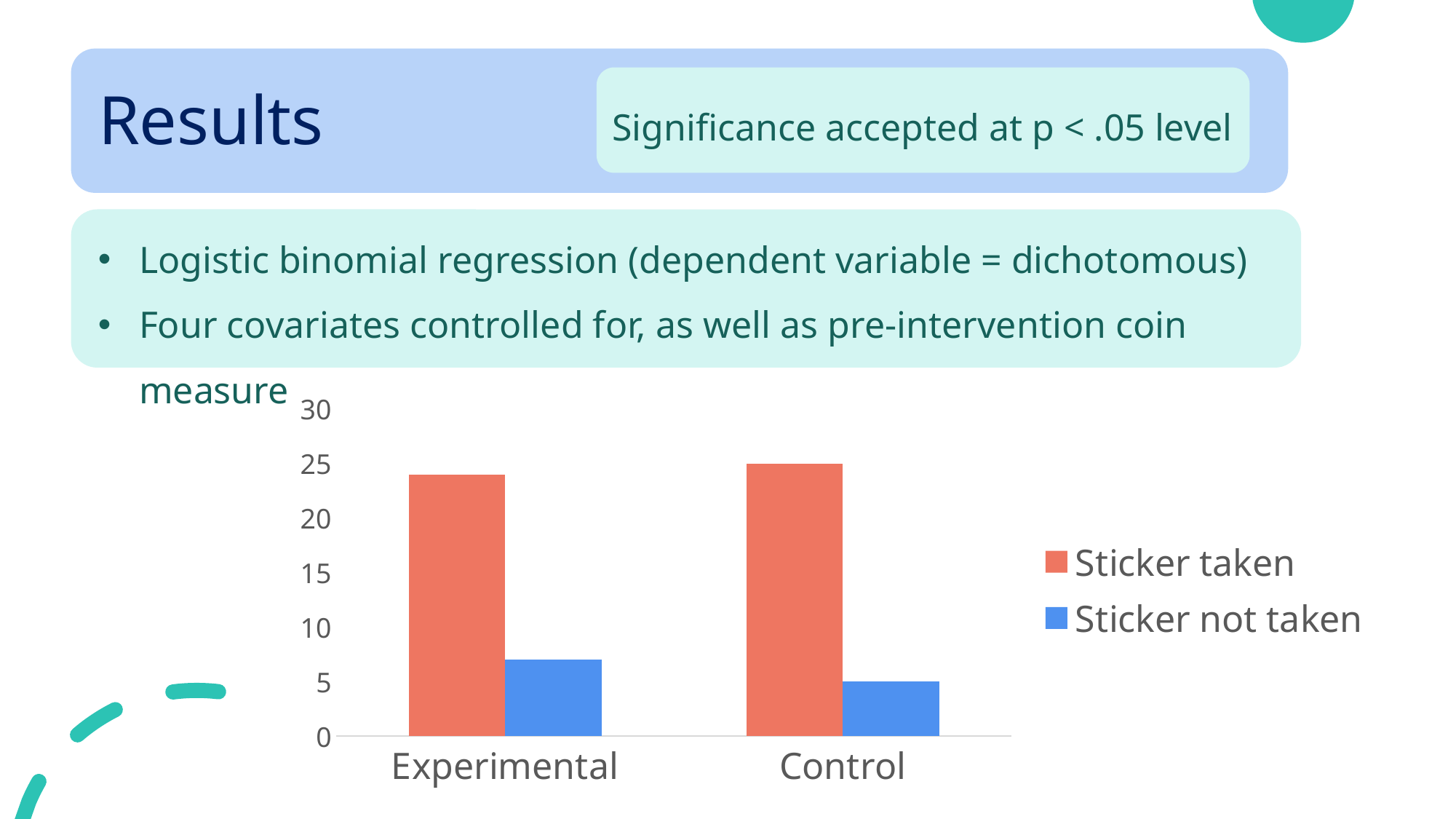
What are the two series listed in the chart's legend? Sticker taken, Sticker not taken Is the 'Sticker not taken' value for Experimental greater or less than 10? less How many categories are shown on the x axis of the chart? 2 Is the 'Sticker taken' value for Control greater or less than 20? greater Is the 'Sticker taken' value for Experimental greater or less than 20? greater Which colour represents the 'Sticker not taken' series in the chart? blue How many series does the chart's legend list? 2 Which category has the higher 'Sticker not taken' value, Experimental or Control? Experimental What kind of chart is shown on the slide? bar chart In the Experimental category, which is larger: 'Sticker taken' or 'Sticker not taken'? Sticker taken Which category has the lower 'Sticker not taken' value, Experimental or Control? Control